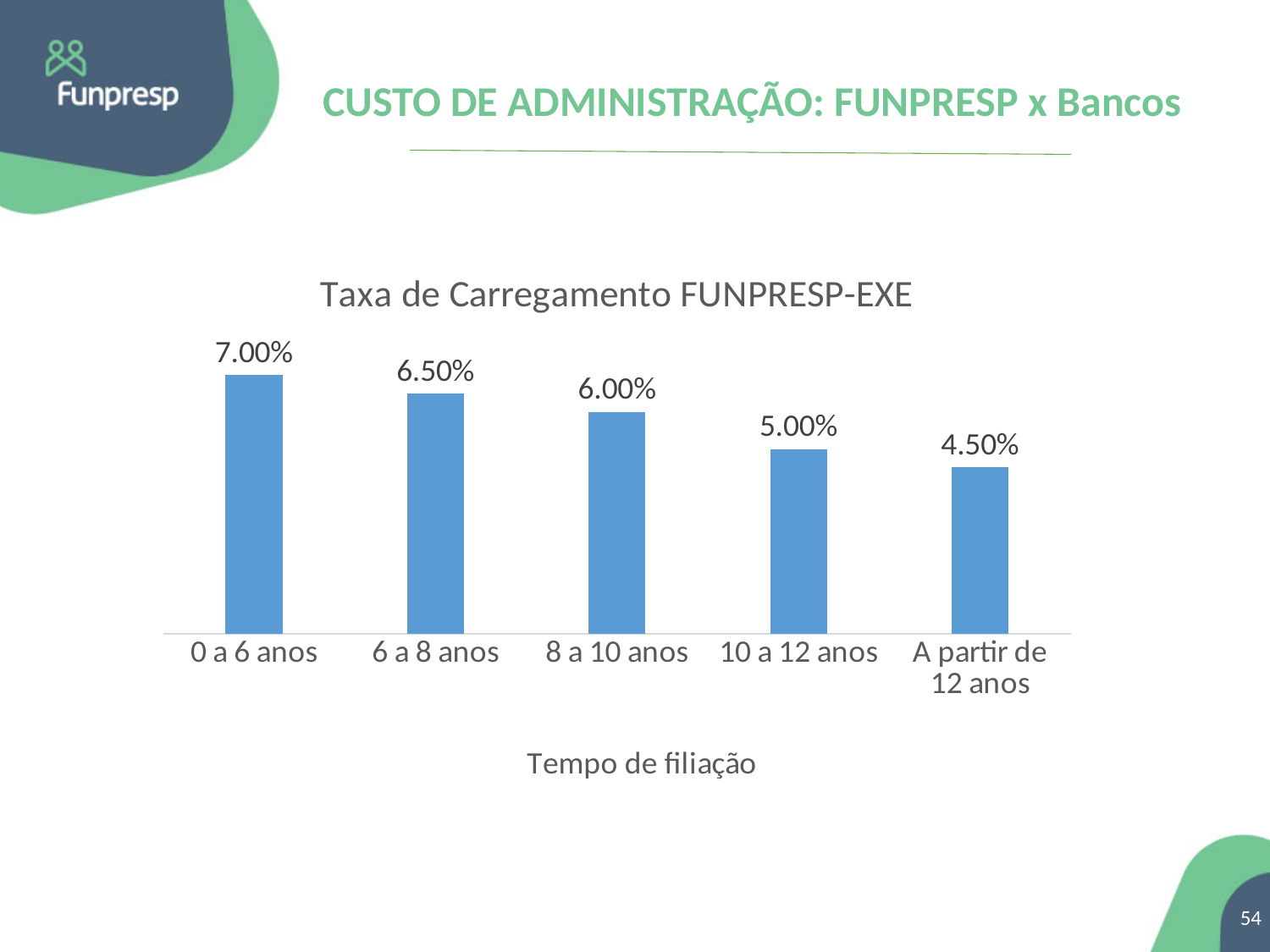
What is the Taxa de Carregamento for A partir de 12 anos? 4.50% Which is larger, the Taxa de Carregamento for 6 a 8 anos or for 8 a 10 anos? 6 a 8 anos Which category has the lowest Taxa de Carregamento? A partir de 12 anos What kind of chart is shown on the slide? Bar chart What is the Taxa de Carregamento for 8 a 10 anos? 6.00% Do the values rise or fall as the Tempo de filiação increases along the x axis? Fall How many categories are shown on the x axis of the chart? 5 What is the Taxa de Carregamento for 10 a 12 anos? 5.00% What is the difference between the Taxa de Carregamento for 0 a 6 anos and for A partir de 12 anos? 2.50% Which category has the highest Taxa de Carregamento? 0 a 6 anos What is the Taxa de Carregamento for 0 a 6 anos? 7.00% What is the difference between the Taxa de Carregamento for 6 a 8 anos and for 10 a 12 anos? 1.50%